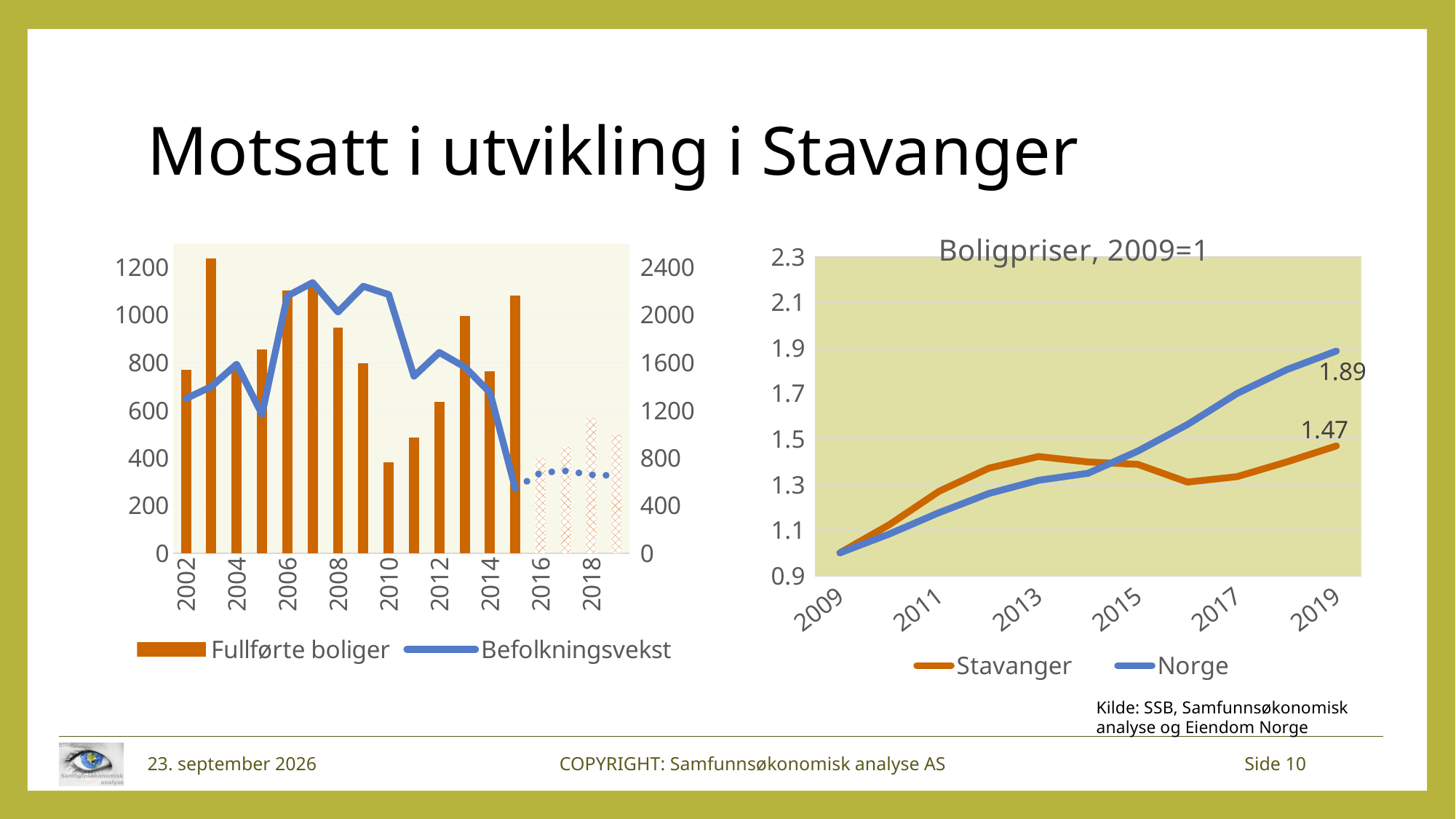
In the chart titled 'Boligpriser, 2009=1', does the Norge series rise or fall from 2009 to 2019? Rises In the left chart, how many series does the legend list? 2 In the left chart, is the Fullførte boliger value for 2010 greater or less than 600? less In the chart titled 'Boligpriser, 2009=1', which series has the higher value in 2019, Stavanger or Norge? Norge In the chart titled 'Boligpriser, 2009=1', what is the value for Stavanger in 2019? 1.47 In the chart titled 'Boligpriser, 2009=1', how many series does the legend list? 2 In the left chart, is the Fullførte boliger value for 2003 greater or less than 1200? greater In the chart titled 'Boligpriser, 2009=1', what is the difference between the Norge and Stavanger values in 2019? 0.42 In the chart titled 'Boligpriser, 2009=1', is the Stavanger value in 2019 greater or less than 1.5? less In the chart titled 'Boligpriser, 2009=1', what is the value for Norge in 2019? 1.89 In the left chart, which year has the highest bar for Fullførte boliger? 2003 What kind of chart is the chart titled 'Boligpriser, 2009=1'? Line chart